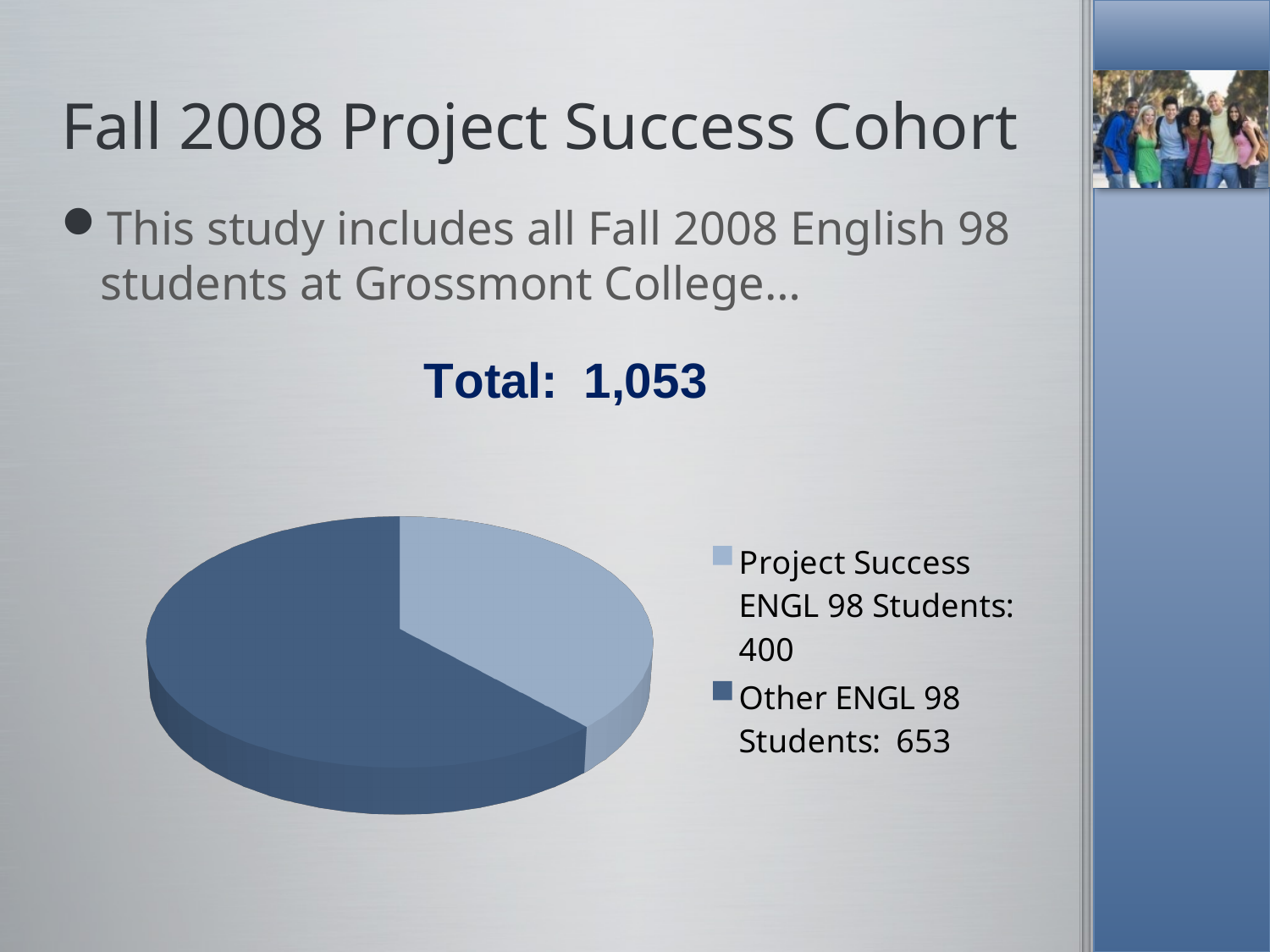
How many Other ENGL 98 Students are shown in the pie chart? 653 Which category has the smaller slice in the pie chart? Project Success ENGL 98 Students How many entries does the legend of the pie chart list? 2 How many slices does the pie chart have? 2 What is the total number of students represented in the pie chart? 1,053 What is the difference between the number of Other ENGL 98 Students and Project Success ENGL 98 Students? 253 How many Project Success ENGL 98 Students are shown in the pie chart? 400 What kind of chart is shown on the slide? Pie chart Which colour represents Other ENGL 98 Students in the pie chart? Dark blue Which category has the larger slice in the pie chart? Other ENGL 98 Students Are there more Project Success ENGL 98 Students or Other ENGL 98 Students? Other ENGL 98 Students